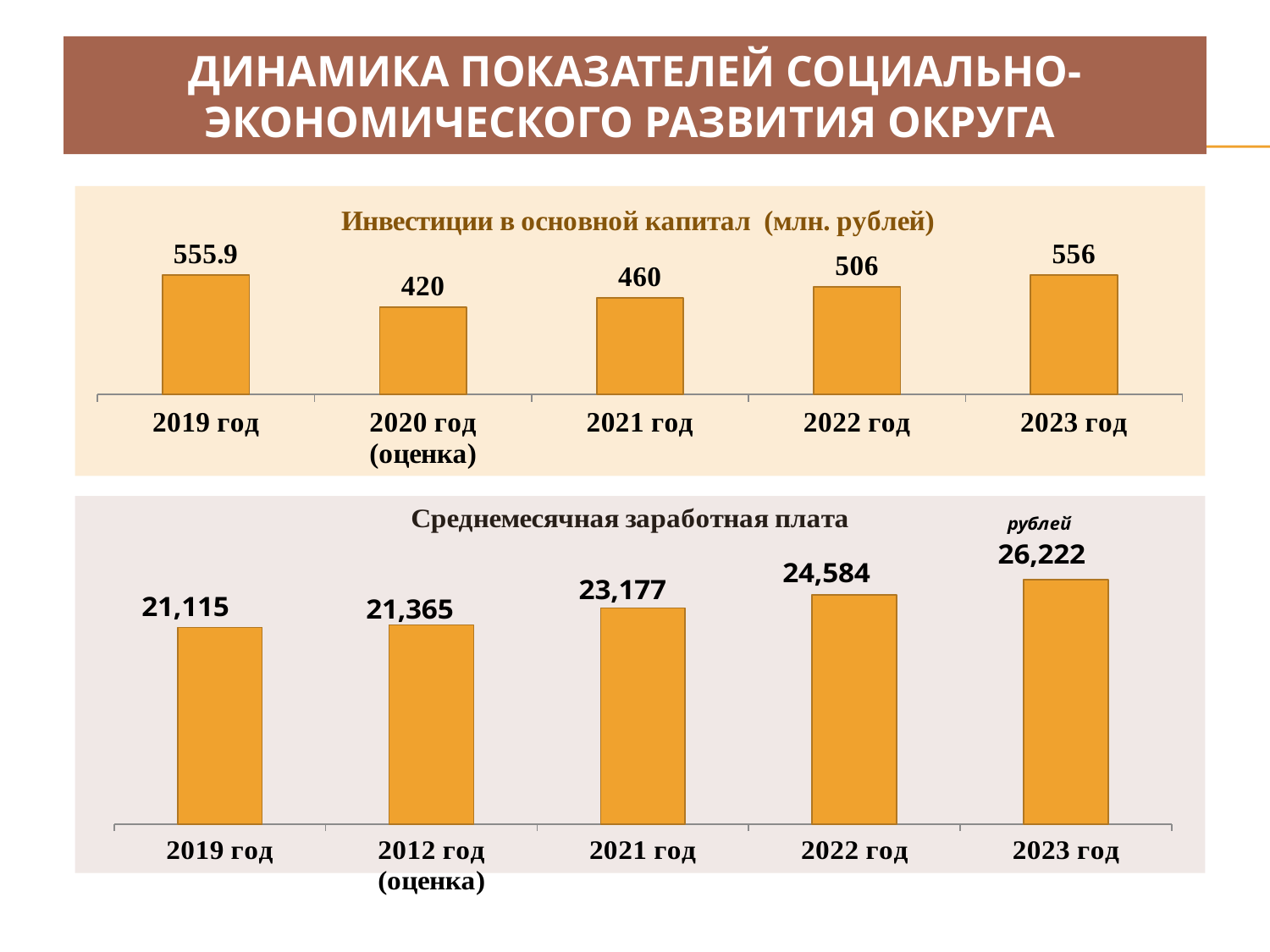
In the chart titled 'Инвестиции в основной капитал (млн. рублей)', what is the difference between the values for 2022 год and 2021 год? 46 In the chart titled 'Среднемесячная заработная плата', which year has the highest value? 2023 год In the chart titled 'Инвестиции в основной капитал (млн. рублей)', which is larger, the value for 2019 год or for 2020 год (оценка)? 2019 год In the chart titled 'Инвестиции в основной капитал (млн. рублей)', which year has the lowest value? 2020 год (оценка) In the chart titled 'Среднемесячная заработная плата', which year has the lowest value? 2019 год In the chart titled 'Среднемесячная заработная плата', what is the difference between the values for 2023 год and 2022 год? 1,638 What kind of chart is the bottom chart titled 'Среднемесячная заработная плата'? bar chart In the chart titled 'Инвестиции в основной капитал (млн. рублей)', what is the value for 2019 год? 555.9 In the chart titled 'Среднемесячная заработная плата', do the values rise or fall from left to right? rise In the chart titled 'Среднемесячная заработная плата', what is the value for 2022 год? 24,584 In the chart titled 'Инвестиции в основной капитал (млн. рублей)', what is the value for 2021 год? 460 In the chart titled 'Инвестиции в основной капитал (млн. рублей)', how many bars are plotted? 5